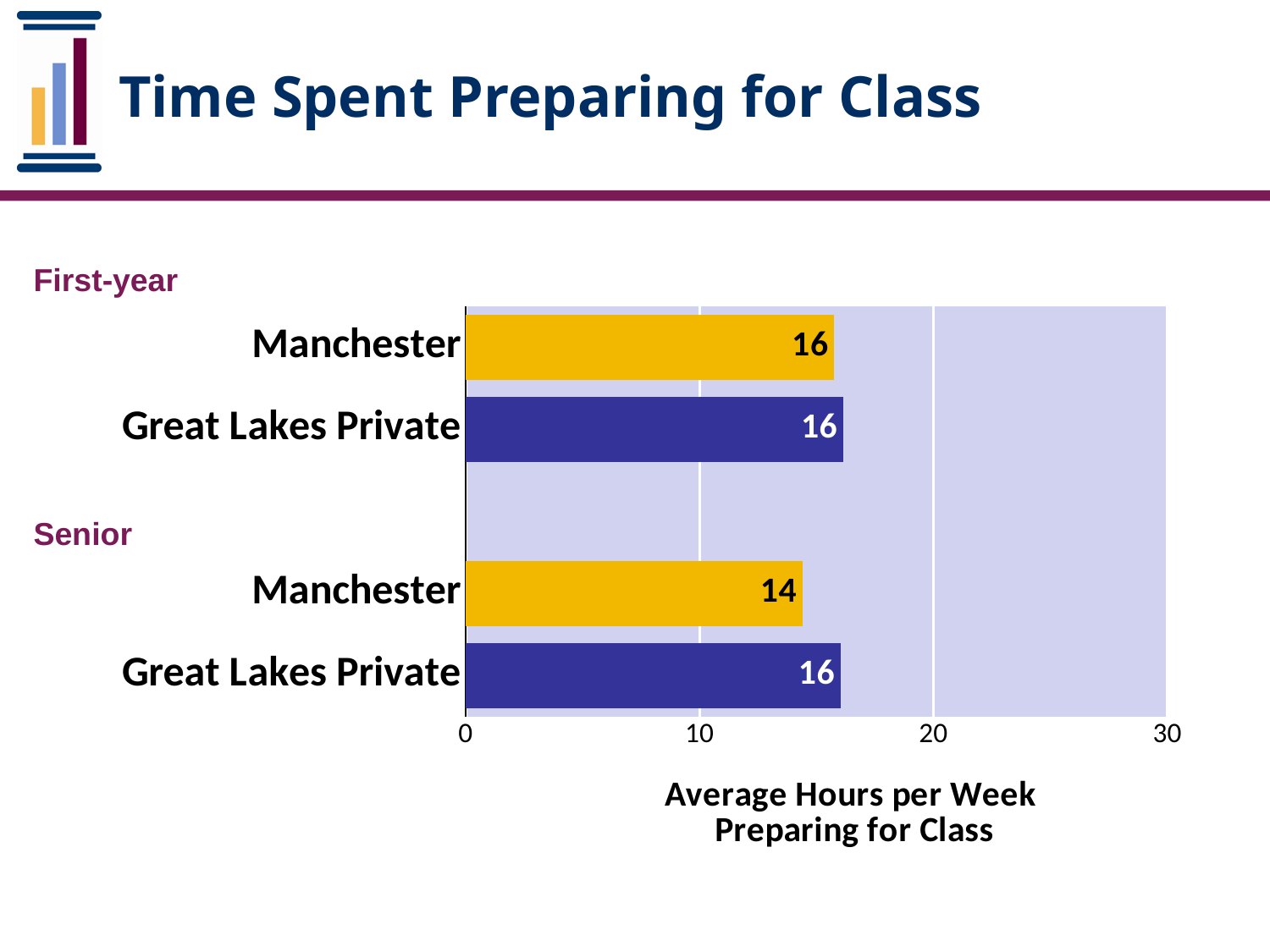
Which is larger: the Senior Manchester value or the Senior Great Lakes Private value? Senior Great Lakes Private Is the value for Senior Manchester greater or less than 20? less What is the average hours per week preparing for class for Senior Manchester students? 14 Which bar has the lowest value on the chart? Senior Manchester What kind of chart is shown on the slide? bar chart What is the average hours per week preparing for class for First-year Manchester students? 16 What is the average hours per week preparing for class for First-year Great Lakes Private students? 16 What is the x-axis label of the chart? Average Hours per Week Preparing for Class What is the difference between the Senior Great Lakes Private value and the Senior Manchester value? 2 What is the maximum value shown on the x axis? 30 How many bars are plotted on the chart? 4 What is the average hours per week preparing for class for Senior Great Lakes Private students? 16